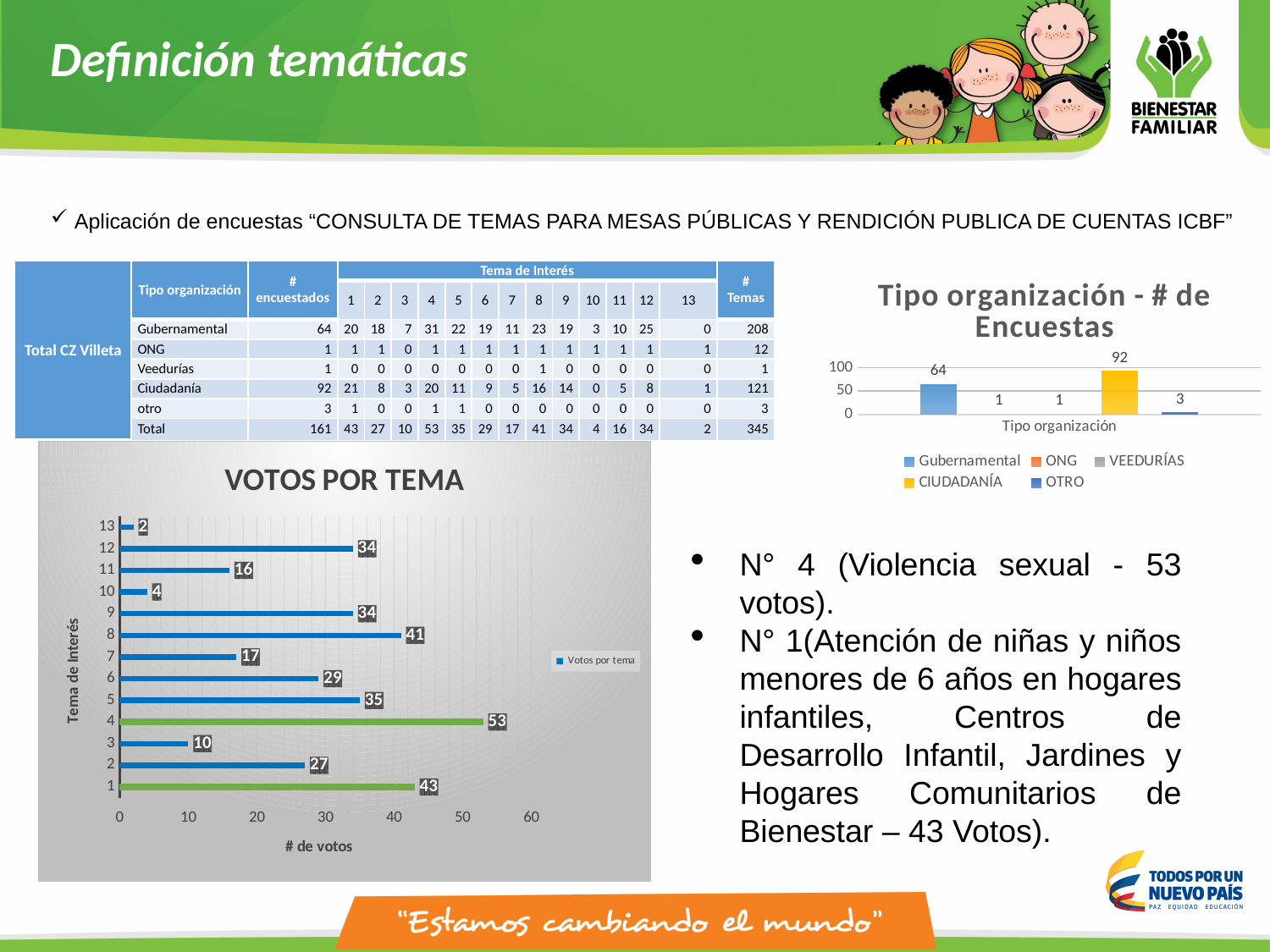
How many series does the legend of the "Tipo organización - # de Encuestas" chart list? 5 In the "VOTOS POR TEMA" chart, which has more votes, tema 5 or tema 6? tema 5 In the "Tipo organización - # de Encuestas" chart, what is the value for Gubernamental? 64 In the "VOTOS POR TEMA" chart, what is the difference in votes between tema 4 and tema 1? 10 In the "Tipo organización - # de Encuestas" chart, what is the value for Ciudadanía? 92 In the "VOTOS POR TEMA" chart, which tema has the fewest votes? 13 In the "VOTOS POR TEMA" chart, which tema has the most votes? 4 In the "Tipo organización - # de Encuestas" chart, what is the difference between Ciudadanía and Gubernamental? 28 What type of chart is "VOTOS POR TEMA"? bar chart In the "VOTOS POR TEMA" chart, how many votes does tema 4 have? 53 How many temas are plotted in the "VOTOS POR TEMA" chart? 13 In the "VOTOS POR TEMA" chart, how many votes does tema 8 have? 41